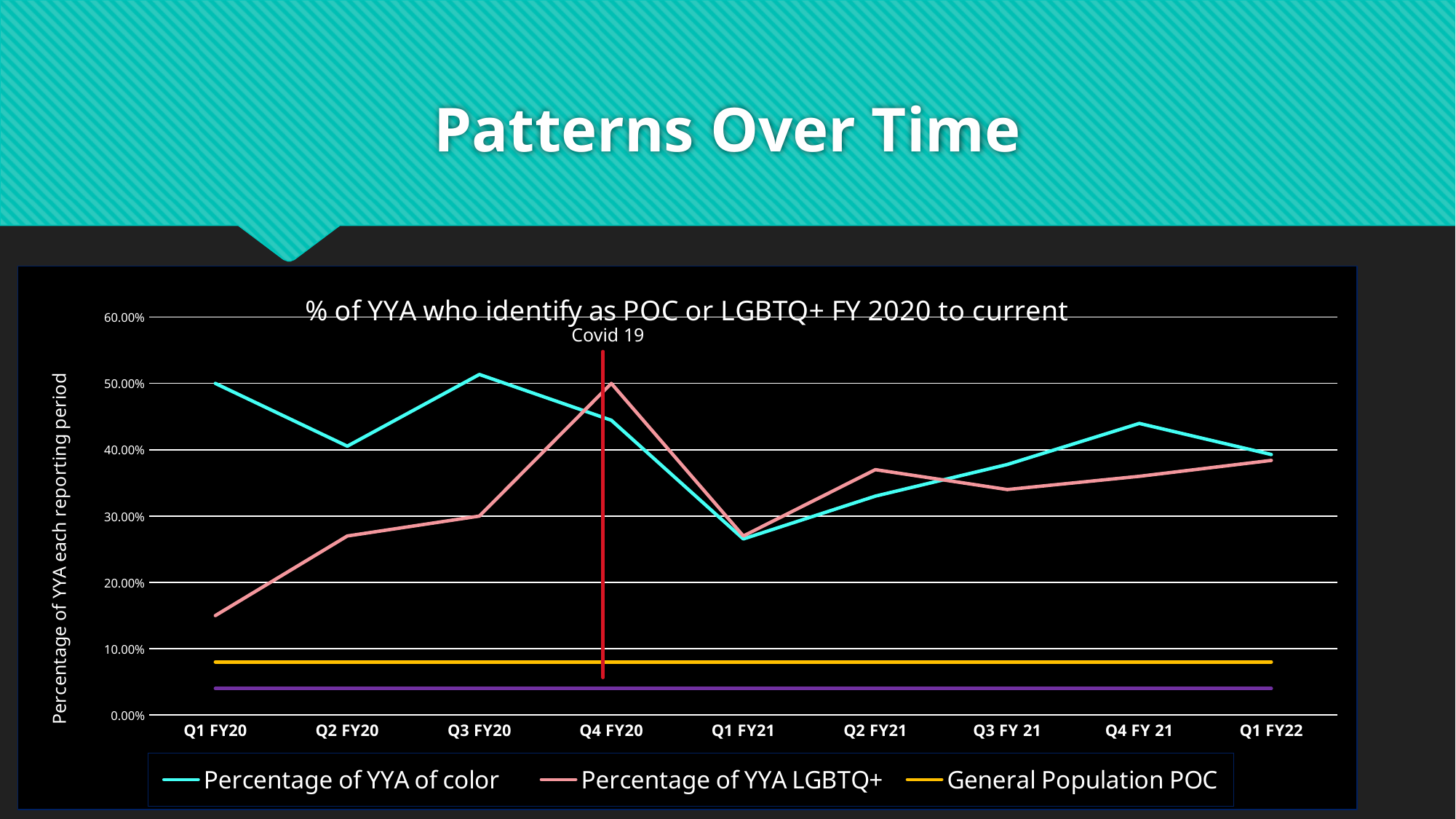
In Q1 FY20, which is larger: the Percentage of YYA of color or the Percentage of YYA LGBTQ+? Percentage of YYA of color Is the Percentage of YYA of color in Q4 FY 21 greater or less than 40.00%? greater What is the title of the chart? % of YYA who identify as POC or LGBTQ+ FY 2020 to current Is the Percentage of YYA of color in Q1 FY21 greater or less than 30.00%? less In which reporting period is the Percentage of YYA LGBTQ+ highest? Q4 FY20 In which reporting period is the Percentage of YYA of color lowest? Q1 FY21 How many reporting periods are shown on the x axis? 9 What kind of chart is shown on the slide? Line chart Does the Percentage of YYA LGBTQ+ rise or fall from Q1 FY20 to Q4 FY20? Rise How many series does the chart legend list? 3 In which reporting period is the Percentage of YYA LGBTQ+ lowest? Q1 FY20 Is the Percentage of YYA LGBTQ+ in Q1 FY20 greater or less than 20.00%? less